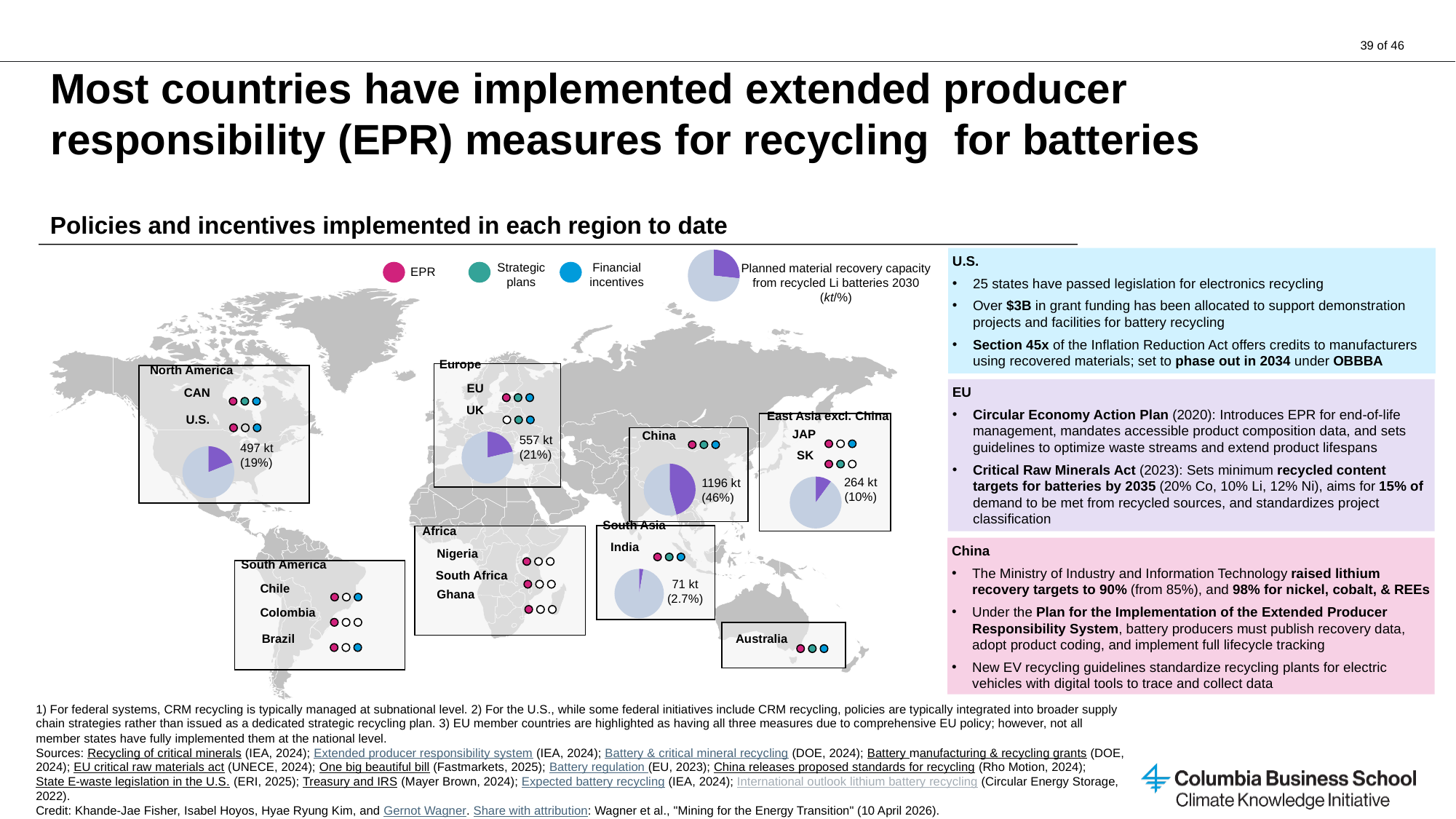
Which region has the highest planned material recovery capacity from recycled Li batteries in 2030? China What is the planned 2030 material recovery capacity shown for North America? 497 kt What share of planned 2030 material recovery capacity is shown for South Asia? 2.7% What is the difference in planned 2030 recovery capacity between China and Europe? 639 kt What is the planned material recovery capacity from recycled Li batteries in 2030 shown for China? 1196 kt How many regions on the map show a pie chart of planned material recovery capacity? 5 What share of planned 2030 material recovery capacity is shown for Europe? 21% Which has a larger planned 2030 recovery capacity, Europe or North America? Europe What kind of chart is used to show planned material recovery capacity on the map? Pie chart Which region has the lowest planned material recovery capacity from recycled Li batteries in 2030? South Asia What is the planned 2030 material recovery capacity shown for East Asia excl. China? 264 kt What unit is the planned material recovery capacity from recycled Li batteries 2030 given in, according to the legend? kt/%